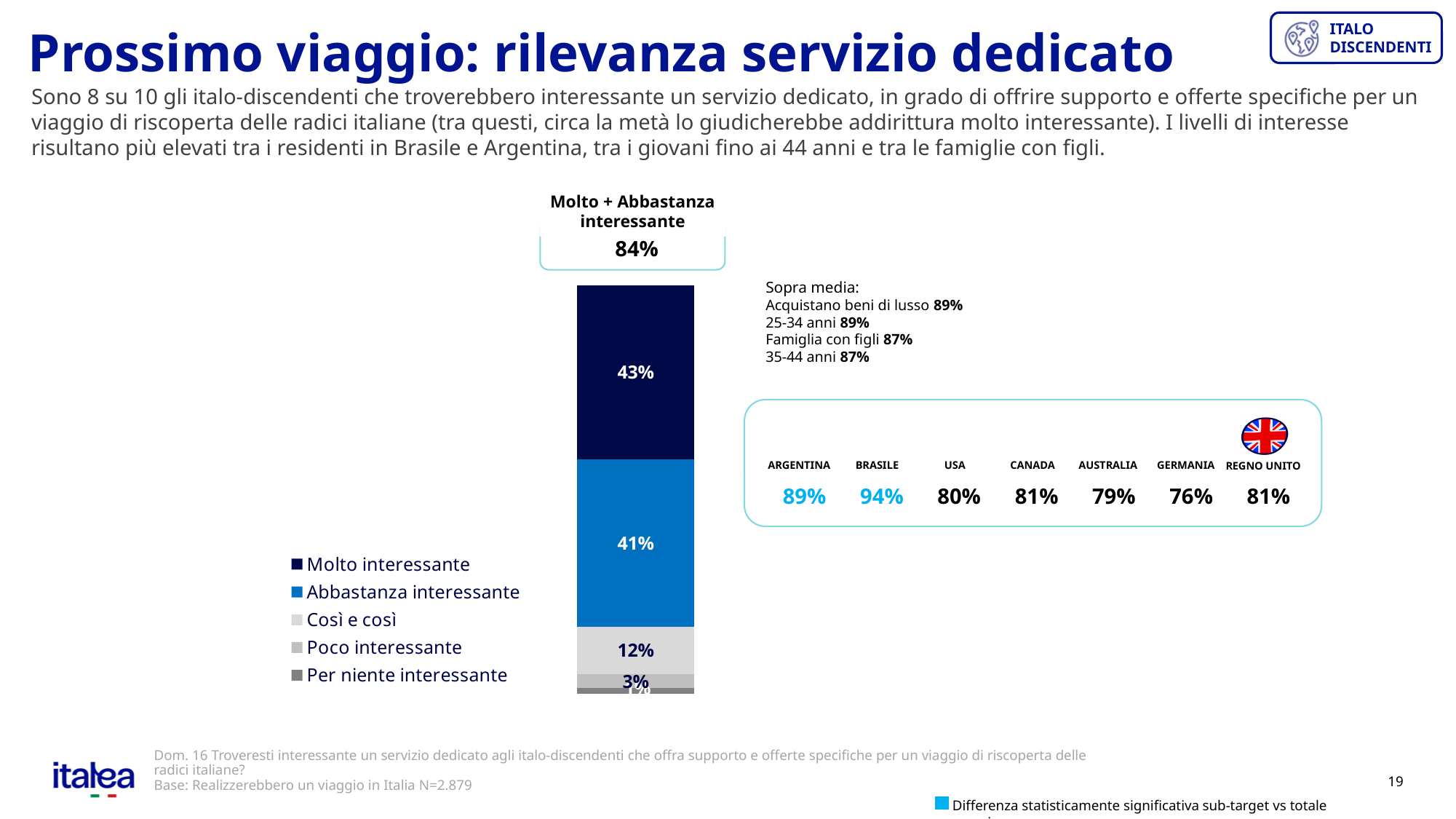
What is the value shown for "Poco interessante" in the stacked bar chart? 3% Which response category has the smallest segment in the stacked bar chart? Per niente interessante What is the value shown for "Così e così" in the stacked bar chart? 12% What colour is the "Molto interessante" segment in the stacked bar chart? Dark navy blue What percentage of respondents answered "Abbastanza interessante" in the stacked bar chart? 41% What is the difference between the "Molto interessante" and "Abbastanza interessante" values in the stacked bar chart? 2 percentage points What kind of chart is used to show the interest levels on this slide? Stacked bar chart How many response categories does the legend of the stacked bar chart list? 5 Which is larger in the stacked bar chart: "Così e così" or "Poco interessante"? Così e così What is the combined total of "Molto interessante" and "Abbastanza interessante" shown above the stacked bar? 84% Which response category has the largest segment in the stacked bar chart? Molto interessante What percentage of respondents answered "Molto interessante" in the stacked bar chart? 43%